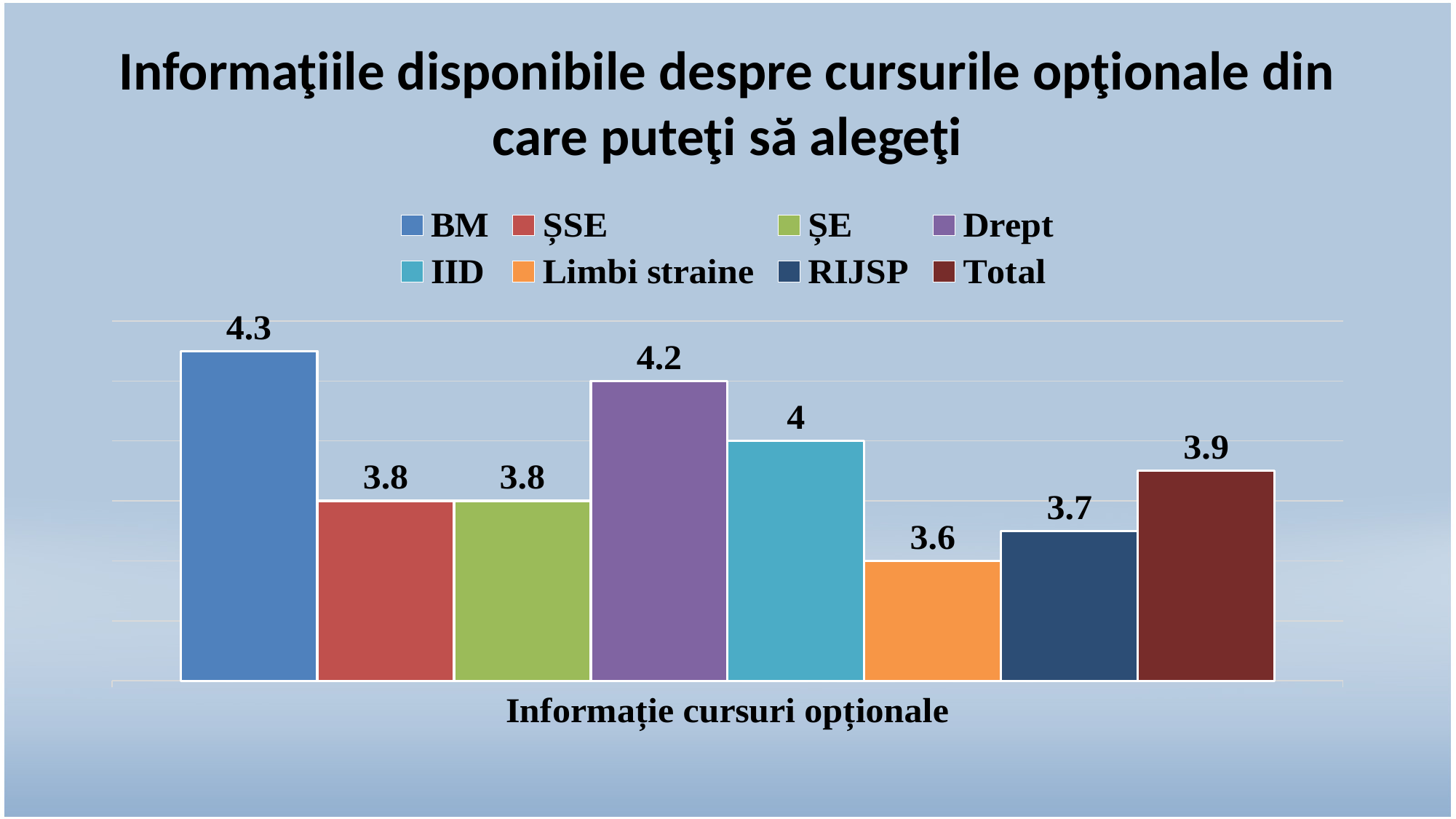
What is the difference between the values for Drept and RIJSP? 0.5 What is the difference between the values for BM and Limbi straine? 0.7 What is the label on the x axis of the chart? Informație cursuri opționale What is the value for Total? 3.9 Which series has the lowest value? Limbi straine What is the value for Drept? 4.2 Which series has the highest value? BM How many series does the legend list? 8 What kind of chart is shown on the slide? Bar chart What is the value for Limbi straine? 3.6 Which is larger, the value for IID or the value for Total? IID What is the value for BM? 4.3